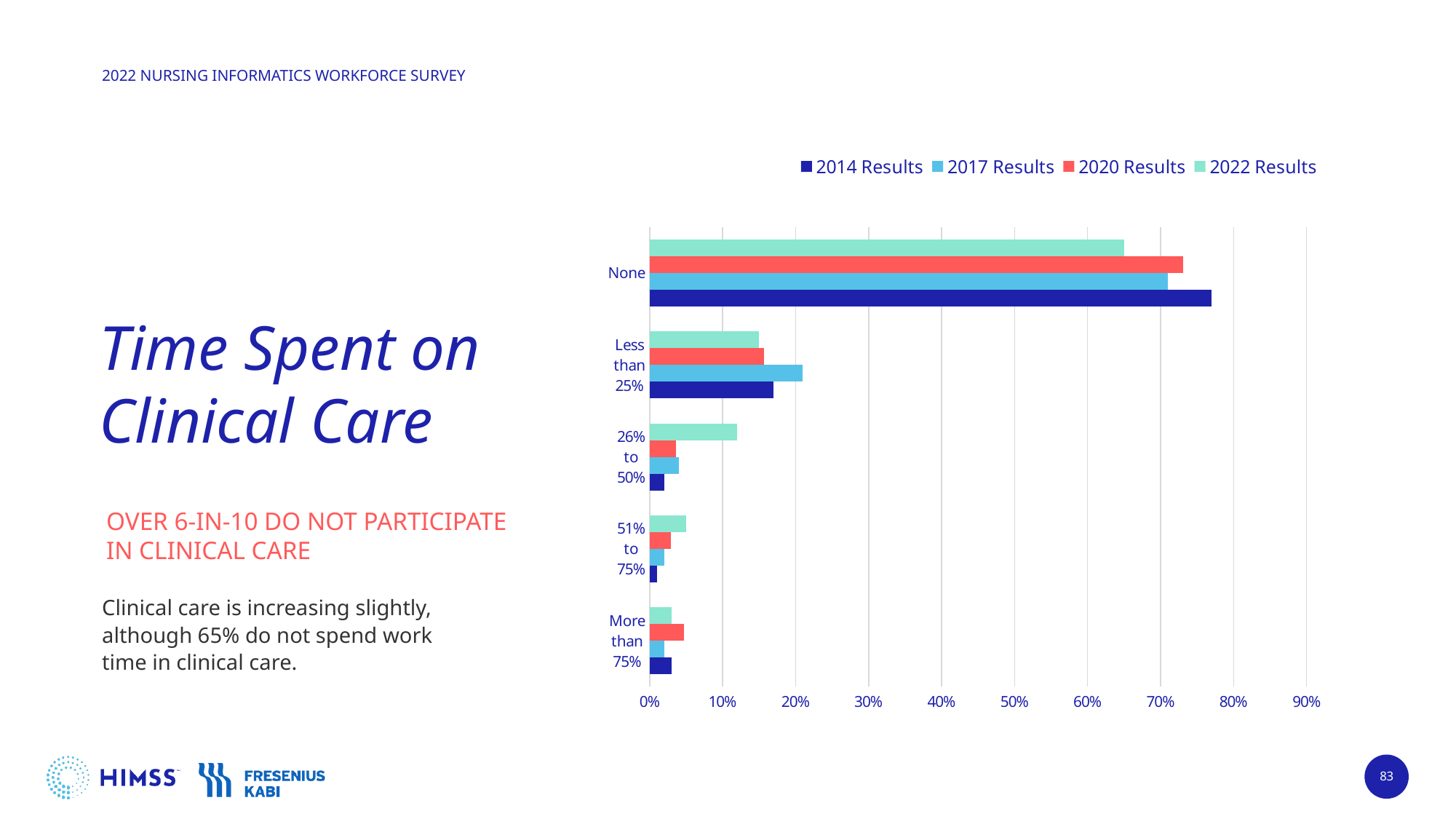
How many series does the legend list? 4 What kind of chart is shown on the slide? bar chart Which series has the lowest value for 51% to 75%? 2014 Results Is the value for None in the 2014 Results greater or less than 70%? greater Which series has the larger value for 26% to 50%: 2022 Results or 2014 Results? 2022 Results Is the value for Less than 25% in the 2017 Results greater or less than 20%? greater Is the value for 26% to 50% in the 2022 Results greater or less than 10%? greater How many categories are shown on the chart? 5 Which category has the highest values across all series? None Which series has the larger value for None: 2014 Results or 2022 Results? 2014 Results Which series is shown in red on the chart? 2020 Results